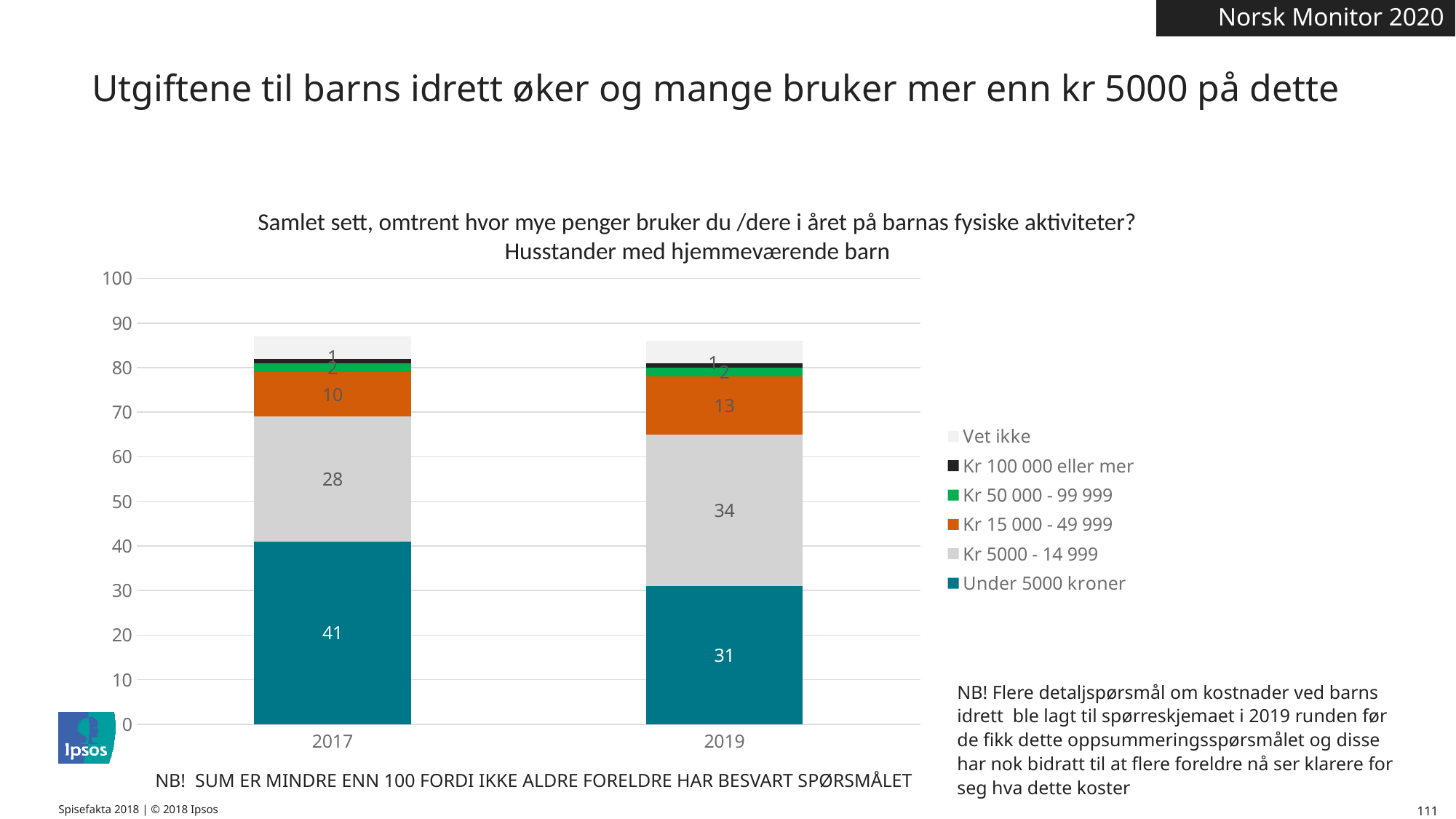
What is the difference between the "Under 5000 kroner" values for 2017 and 2019? 10 What is the value for "Kr 15 000 - 49 999" in 2017? 10 What is the difference between the "Kr 5000 - 14 999" values for 2019 and 2017? 6 In which year is the value for "Kr 15 000 - 49 999" larger, 2017 or 2019? 2019 What is the value for "Kr 100 000 eller mer" in 2019? 1 How many series does the legend list? 6 What is the value for "Kr 5000 - 14 999" in 2019? 34 Is the total height of the 2017 stacked bar greater or less than 80? greater How many years (categories) are shown on the x axis? 2 Does the value for "Under 5000 kroner" rise or fall from 2017 to 2019? Fall What kind of chart is shown on the slide? Stacked bar chart What is the value for "Under 5000 kroner" in 2017? 41